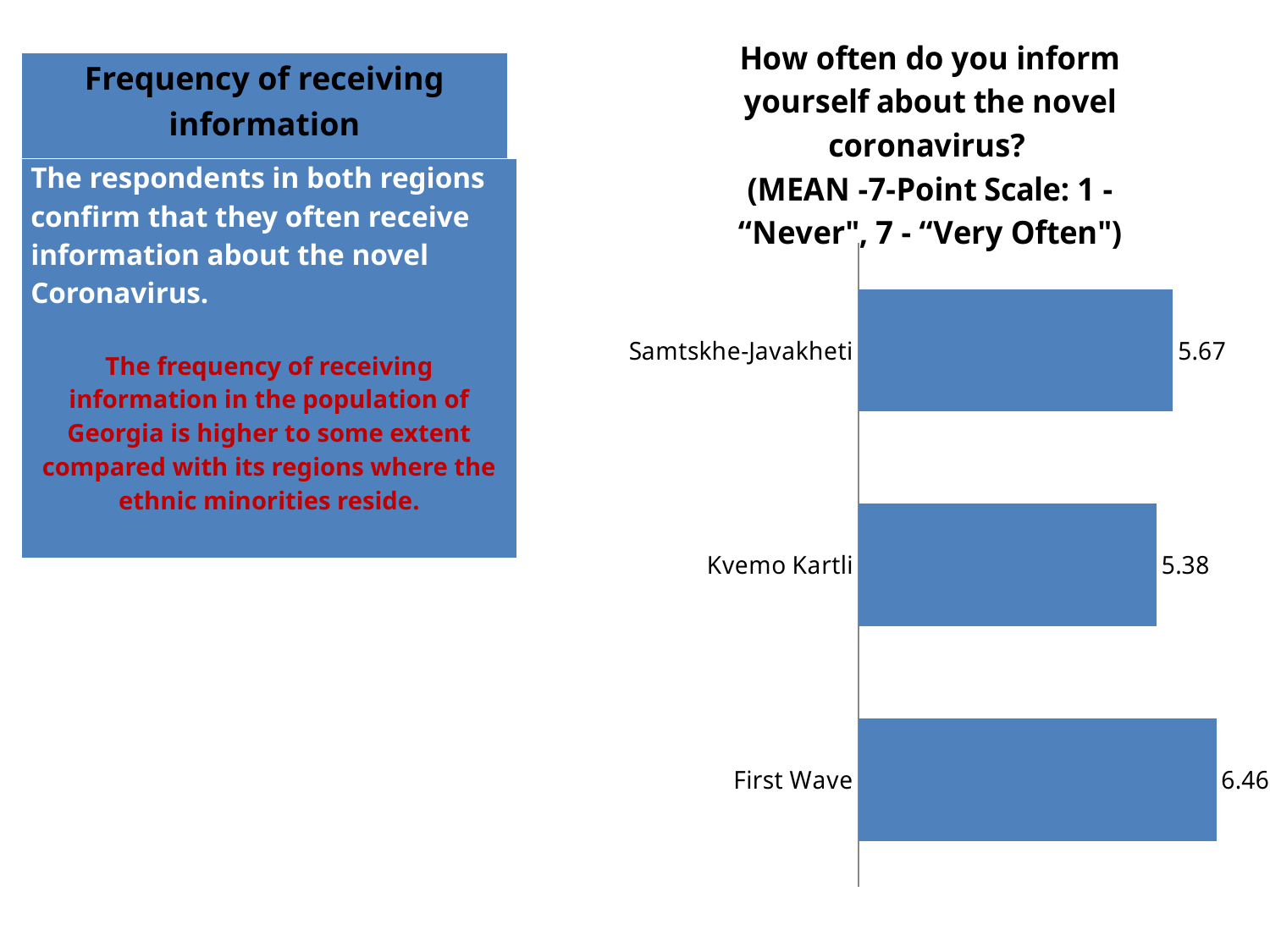
What is the value for Samtskhe-Javakheti? 5.67 What is the difference between the values for First Wave and Kvemo Kartli? 1.08 What is the value for Kvemo Kartli? 5.38 What is the difference between the values for Samtskhe-Javakheti and Kvemo Kartli? 0.29 What is the value for First Wave? 6.46 Which category has the lowest value? Kvemo Kartli What kind of chart is shown on the slide? Bar chart What colour are the bars in the chart? Blue What scale is used for the mean values in the chart, according to its title? 7-Point Scale: 1 - "Never", 7 - "Very Often" How many categories are shown in the chart? 3 Which category has the highest value? First Wave Which is larger, the value for Samtskhe-Javakheti or the value for Kvemo Kartli? Samtskhe-Javakheti